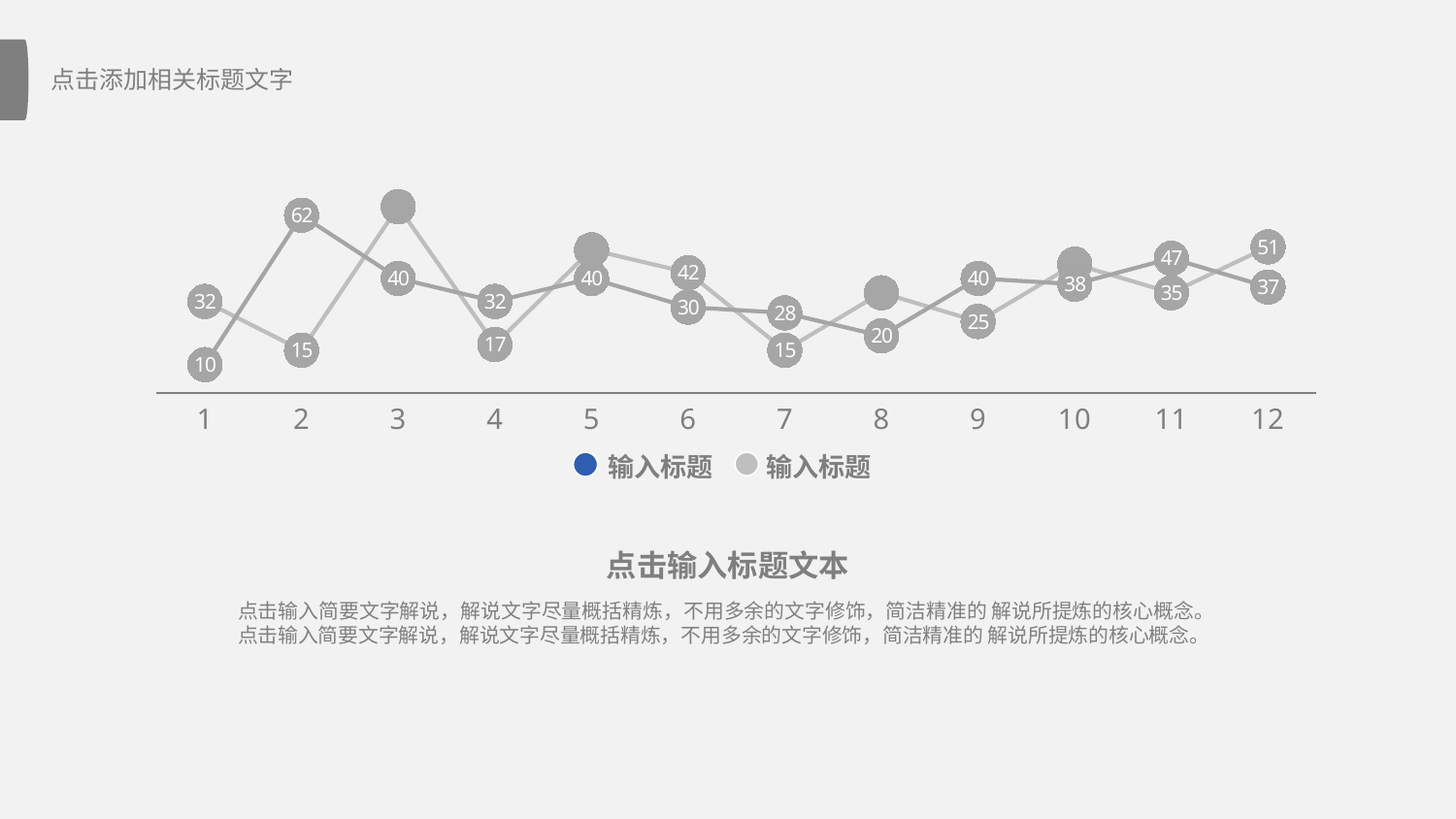
What is the smaller of the two labeled values at category 12? 37 What is the lower labeled value at category 7? 15 What kind of chart is shown on the slide? line chart How many series does the chart's legend list? 2 What is the larger of the two labeled values at category 2? 62 Which category has the lowest value on the chart? 1 What text is used for the series names in the legend? 输入标题 What is the difference between the two labeled values at category 1? 22 At category 6, which of the two labeled values is larger, 42 or 30? 42 What are the two data labels shown at category 1? 32 and 10 What is the difference between the two labeled values at category 2? 47 How many categories are shown along the x axis of the chart? 12